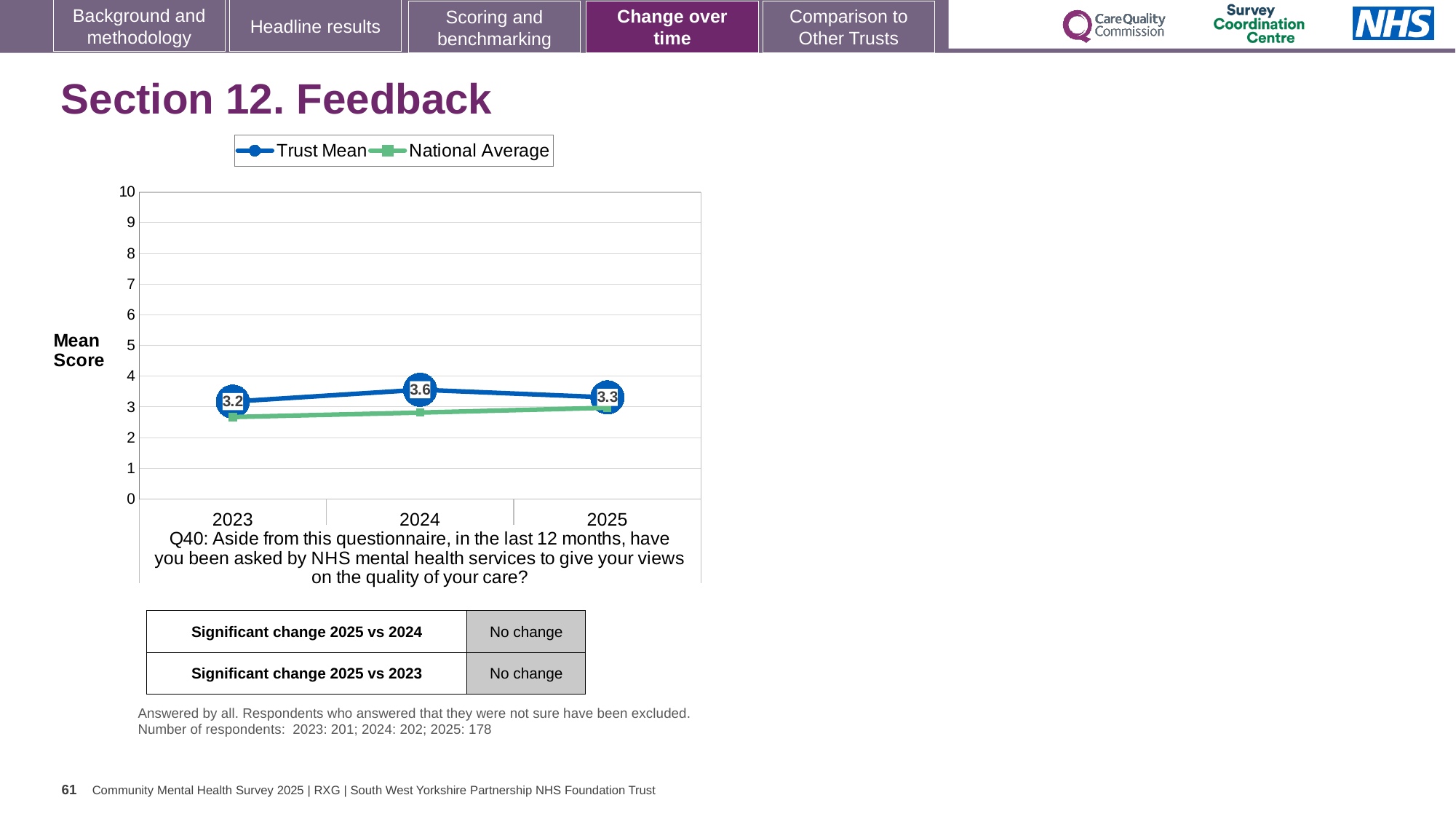
What is the difference between the Trust Mean in 2024 and in 2023? 0.4 What is the Trust Mean value for 2023? 3.2 Which is larger, the Trust Mean in 2024 or in 2025? 2024 In which year is the Trust Mean highest? 2024 Is the National Average value for 2023 greater or less than 3? less What is the label of the y axis? Mean Score What kind of chart is shown on the slide? line chart What is the Trust Mean value for 2024? 3.6 How many series does the legend list? 2 How many years are shown on the x axis? 3 What is the Trust Mean value for 2025? 3.3 In which year is the Trust Mean lowest? 2023